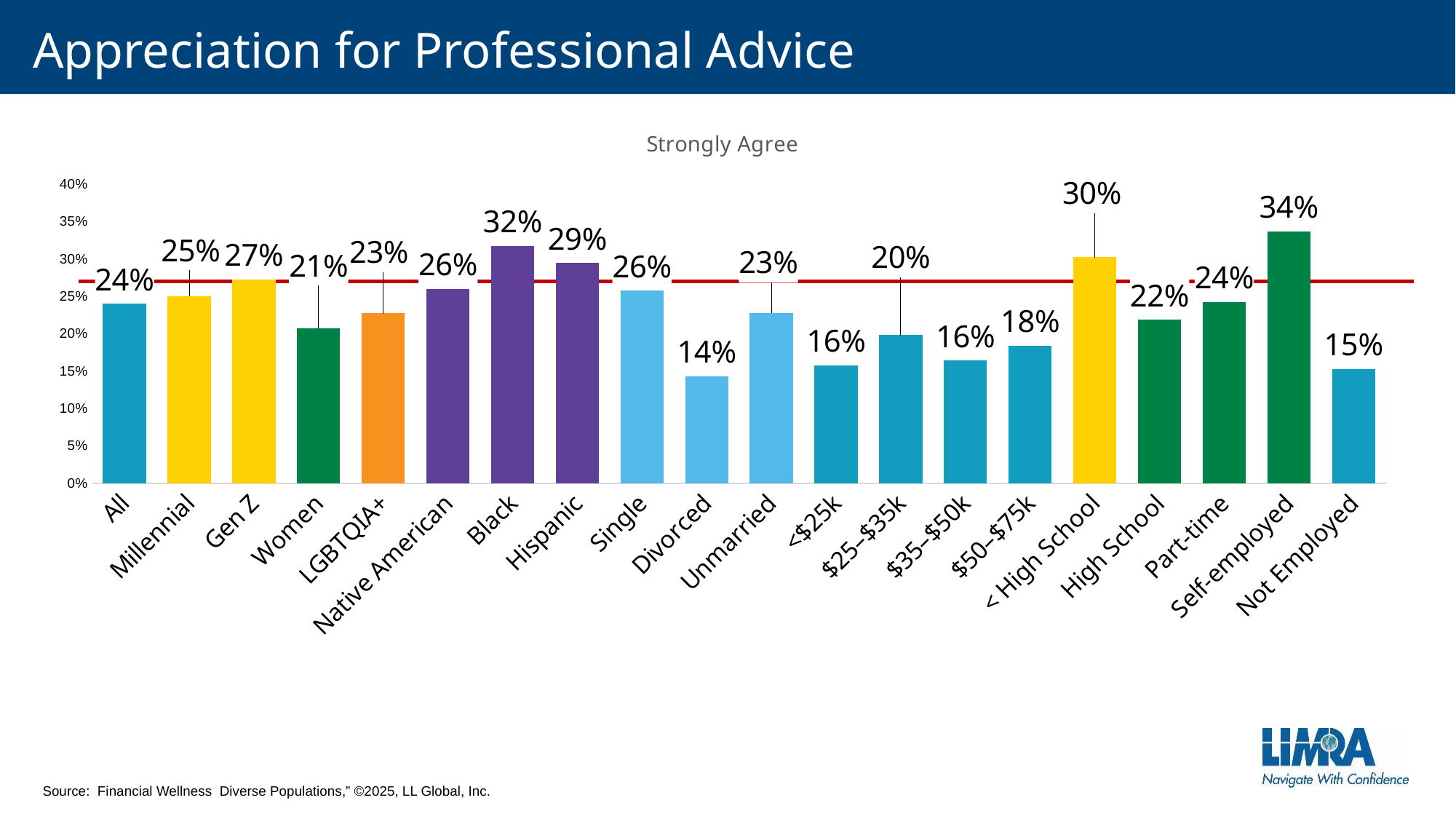
Which is larger, the value for Gen Z or the value for Women? Gen Z Which category has the lowest value? Divorced What kind of chart is shown on the slide? Bar chart What is the value for < High School? 30% What is the value for Black? 32% What is the value for All? 24% What is the subtitle shown above the chart? Strongly Agree What is the difference between the values for Self-employed and Not Employed? 19% Which category has the highest value? Self-employed How many categories are shown on the chart? 20 What is the difference between the values for Black and Hispanic? 3% What is the value for Divorced? 14%